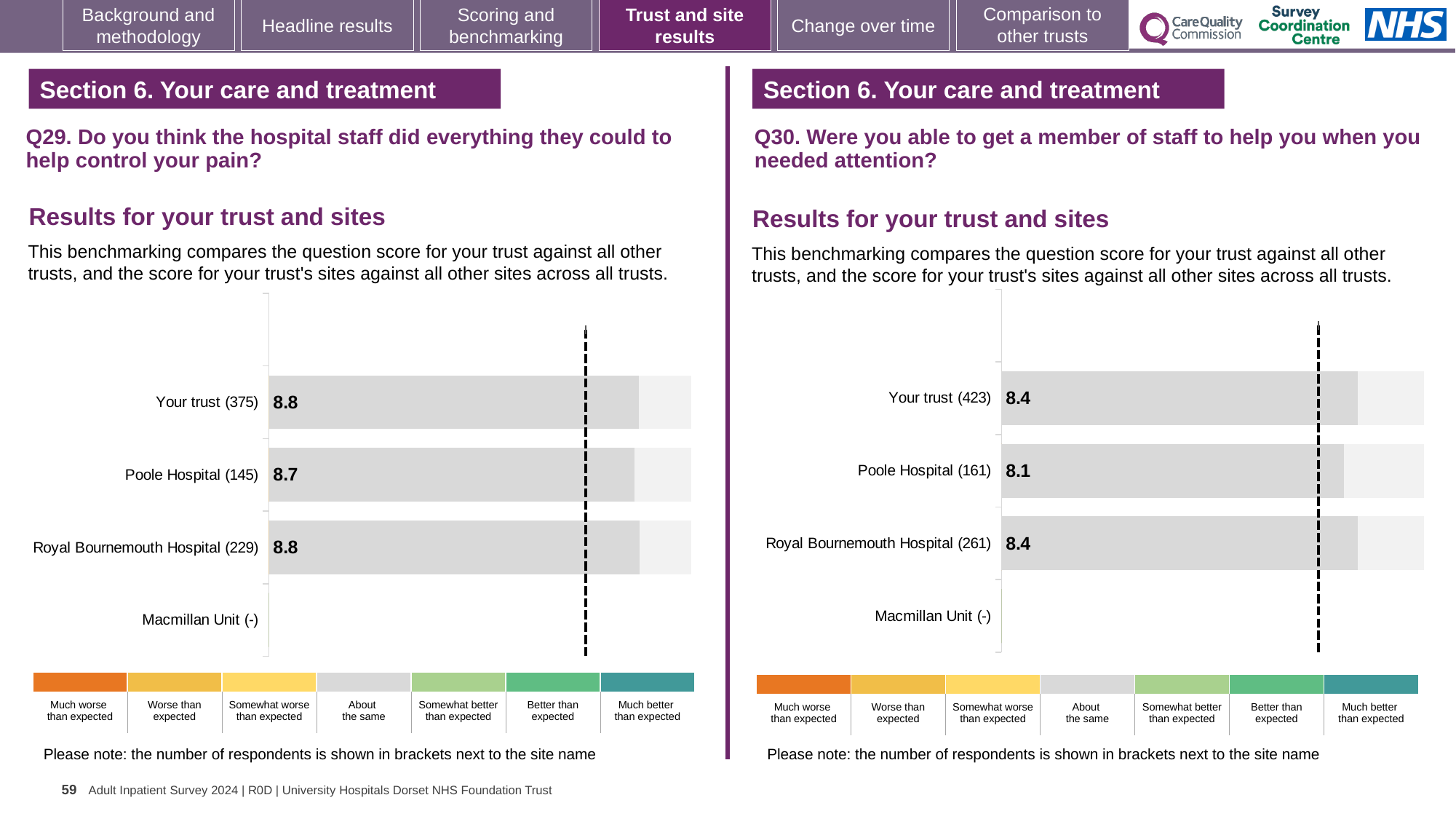
On the Q30 chart (right), what is the score for Poole Hospital? 8.1 On the Q30 chart (right), which site has the lowest score? Poole Hospital On the Q29 chart (left), what is the score for Poole Hospital? 8.7 On the Q29 chart (left), how many respondents are shown in brackets for Royal Bournemouth Hospital? 229 On the Q29 chart (left), what is the score for Your trust? 8.8 What kind of chart is used on the Q30 chart (right)? Bar chart On the Q30 chart (right), what is the score for Royal Bournemouth Hospital? 8.4 On the Q29 chart (left), what is the difference between the scores for Royal Bournemouth Hospital and Poole Hospital? 0.1 On the Q30 chart (right), how many respondents are shown in brackets for Your trust? 423 On the Q30 chart (right), what is the difference between the scores for Your trust and Poole Hospital? 0.3 How many rows (sites including Your trust) are listed on the Q29 chart (left)? 4 On the Q29 chart (left), which has the lower score, Poole Hospital or Royal Bournemouth Hospital? Poole Hospital